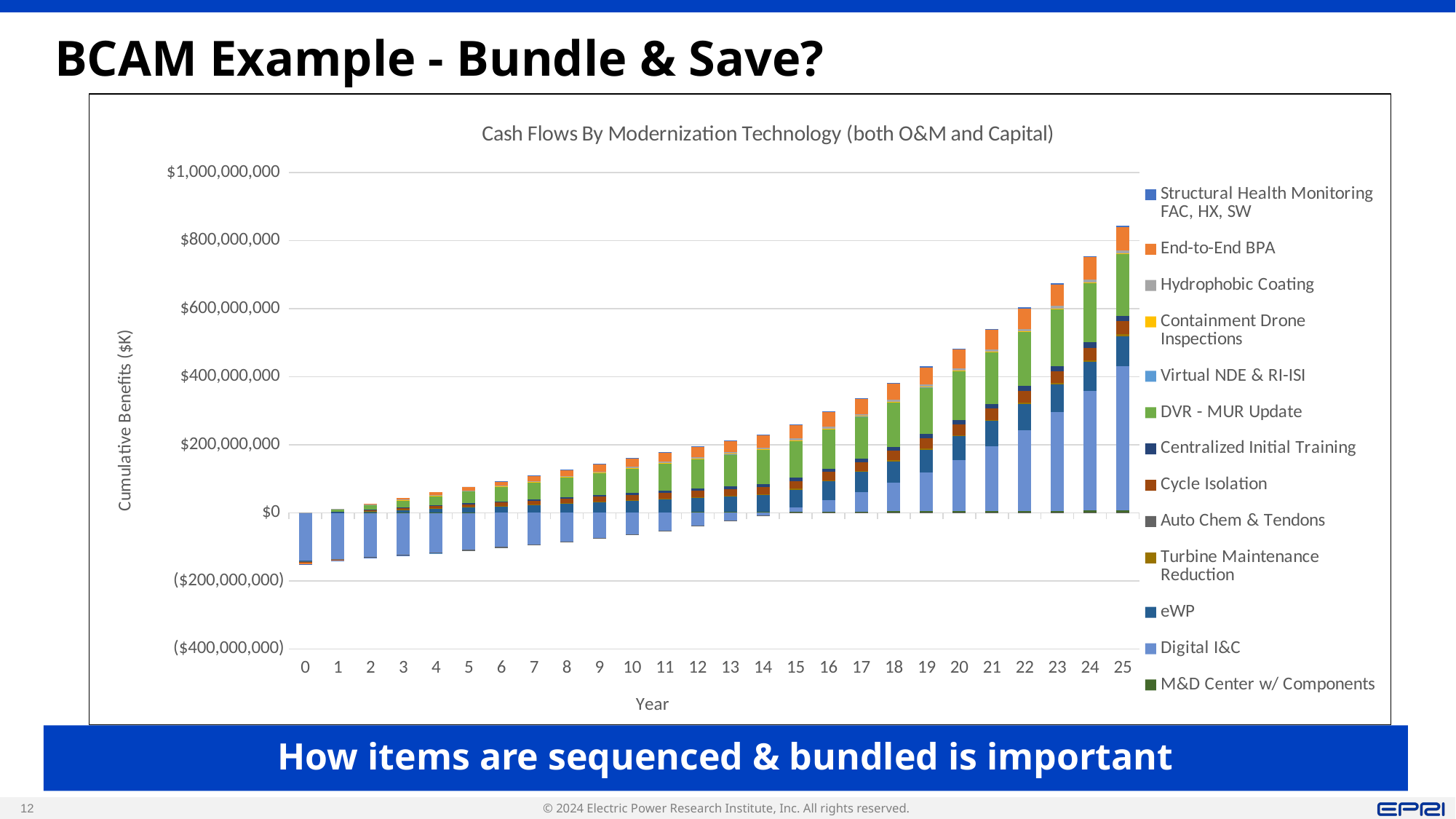
Is the top of the stacked bar for year 20 greater or less than $400,000,000? greater Is the top of the stacked bar for year 10 greater or less than $200,000,000? less What type of chart is shown on the slide? Stacked bar chart Is the Digital I&C value for year 0 greater or less than $0? less How many series does the chart's legend list? 13 Which year has the lowest (most negative) bar? 0 Do the cumulative benefits rise or fall as the year increases from 0 to 25? rise How many years (categories) are plotted along the x axis? 26 Which year has the tallest positive stacked bar? 25 What is the title of the chart? Cash Flows By Modernization Technology (both O&M and Capital) What is the label of the y axis? Cumulative Benefits ($K)